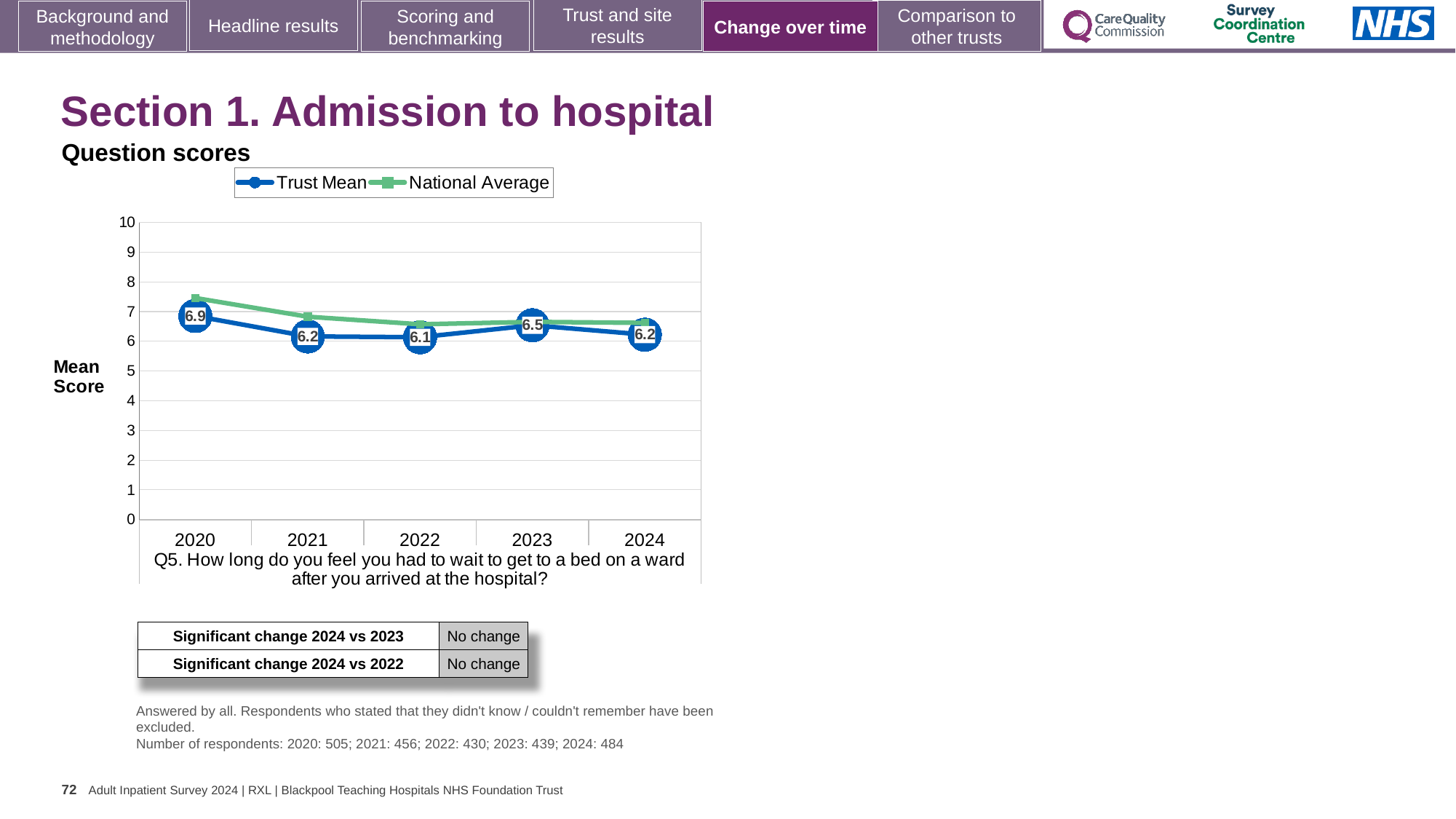
Is the National Average value for 2020 greater or less than 7? greater What kind of chart is shown on the slide? Line chart How many years are plotted on the x axis? 5 In which year is the Trust Mean score lowest? 2022 What is the difference between the Trust Mean score in 2020 and in 2021? 0.7 What is the Trust Mean score for 2022? 6.1 What is the Trust Mean score for 2024? 6.2 Does the Trust Mean score rise or fall from 2020 to 2022? Fall How many series does the legend list? 2 In which year is the Trust Mean score highest? 2020 Which is larger, the Trust Mean score in 2023 or in 2024? 2023 What is the Trust Mean score for 2020? 6.9